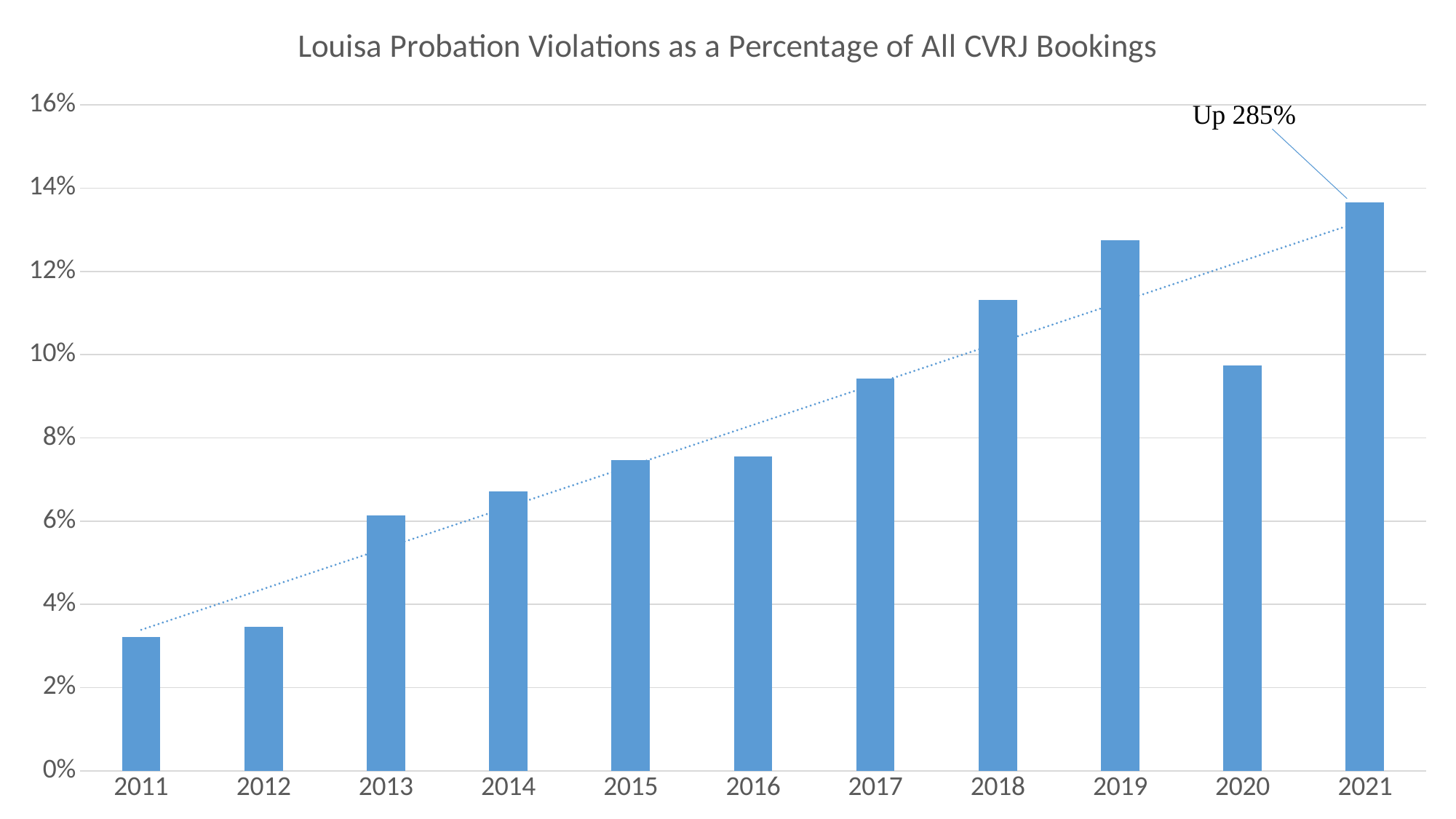
What does the annotation next to the 2021 bar say? Up 285% What is the title of the chart? Louisa Probation Violations as a Percentage of All CVRJ Bookings Which year has the larger value, 2019 or 2020? 2019 Do the values generally rise or fall from 2011 to 2021? rise Is the value for 2011 greater or less than 4%? less Is the value for 2020 greater or less than 10%? less Is the value for 2018 greater or less than 10%? greater Which year has the lowest value? 2011 What kind of chart is shown on the slide? bar chart Which year has the highest value? 2021 How many years are shown on the x axis? 11